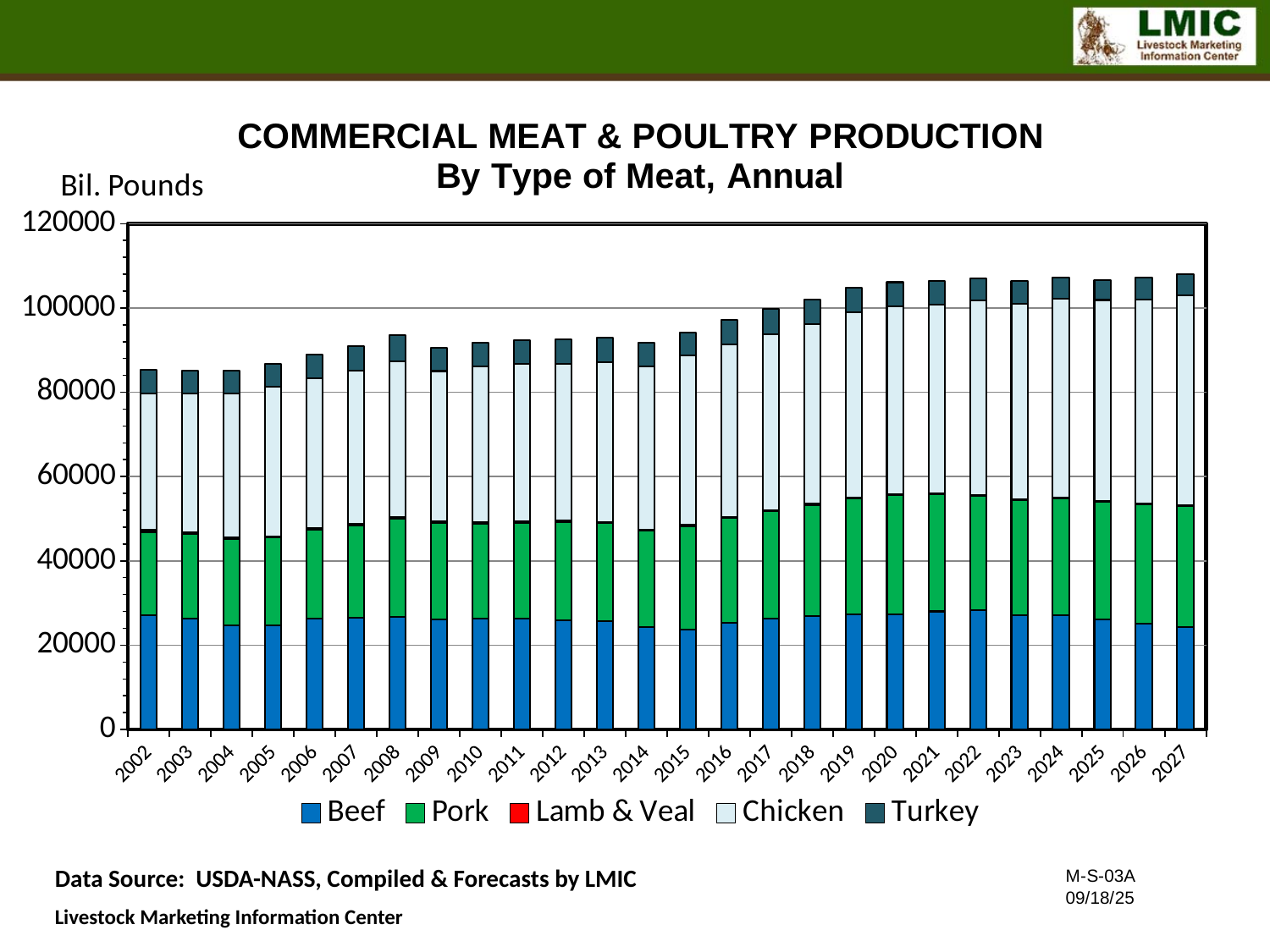
Is the total production for 2027 greater or less than 120000? less What unit is shown on the y axis label? Bil. Pounds Is the Beef value for 2002 greater or less than 20000? greater How many series does the legend list? 5 Is the total production for 2027 larger or smaller than the total for 2002? larger Which series are listed in the legend? Beef, Pork, Lamb & Veal, Chicken, Turkey Is the total production for 2016 greater or less than 100000? less How many years are shown along the x axis? 26 Does total production generally rise or fall from 2002 to 2027? rise What kind of chart is shown on the slide? Stacked bar chart